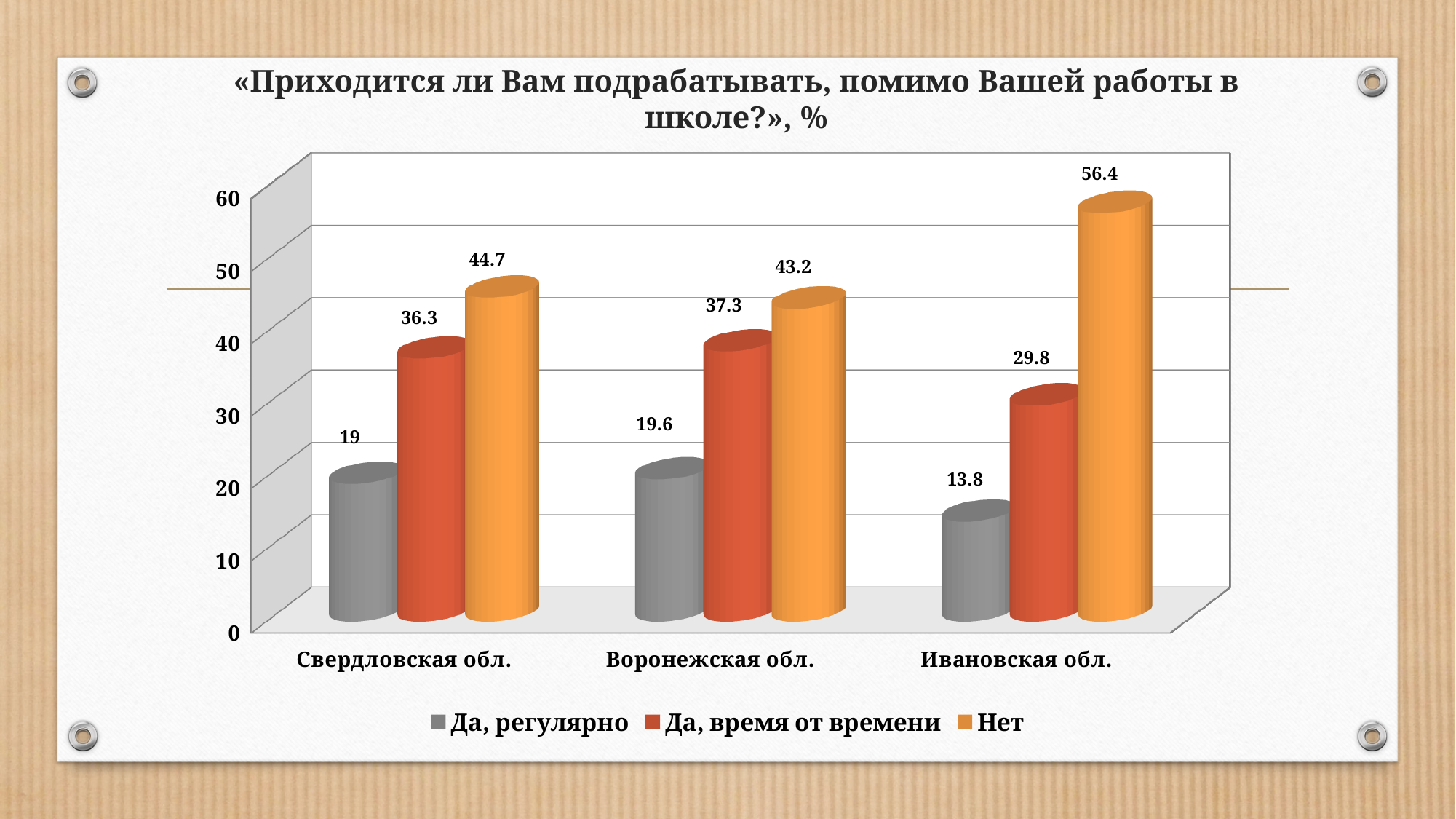
Which is larger: "Да, время от времени" in Свердловская обл. or in Ивановская обл.? Свердловская обл. Which region has the highest value for "Нет"? Ивановская обл. How many series does the legend list? 3 What kind of chart is shown? bar chart How many regions are shown on the x axis? 3 What is the difference between the "Нет" values for Ивановская обл. and Свердловская обл.? 11.7 What is the value for "Нет" in Ивановская обл.? 56.4 How do the "Да, регулярно" values change from Воронежская обл. to Ивановская обл.? fall Which colour represents the "Нет" series? orange What is the value for "Да, время от времени" in Воронежская обл.? 37.3 What is the value for "Да, регулярно" in Свердловская обл.? 19 Which region has the lowest value for "Да, регулярно"? Ивановская обл.